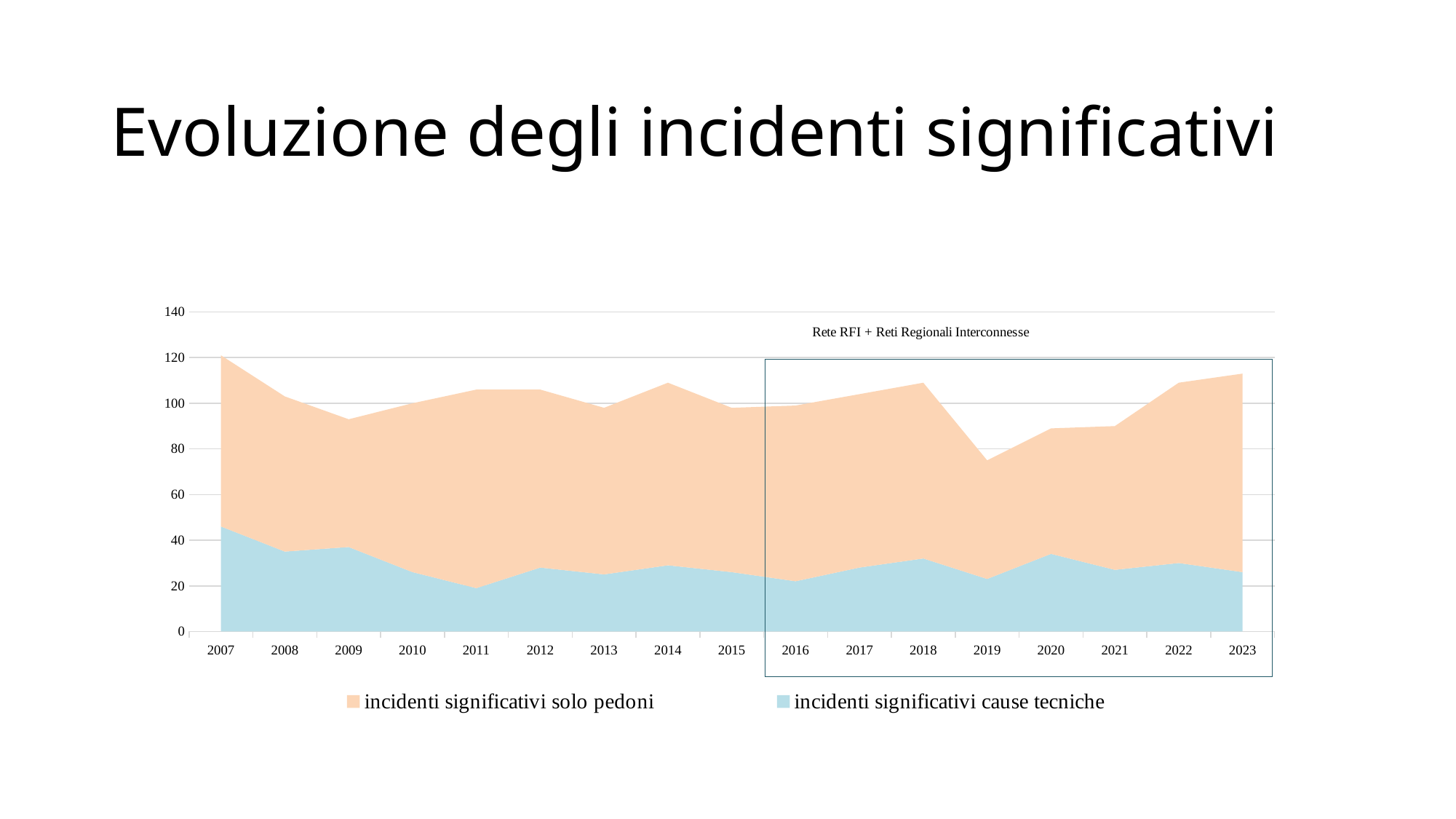
Does the value for 'incidenti significativi cause tecniche' rise or fall from 2007 to 2011? fall In which year is the total of significant incidents (top of the stacked area) lowest? 2019 What label is written above the boxed region covering 2016 to 2023? Rete RFI + Reti Regionali Interconnesse Is the total of significant incidents in 2023 greater or less than 100? greater Is the value for 'incidenti significativi cause tecniche' in 2007 greater or less than 40? greater How many series does the legend list? 2 Is the total of significant incidents in 2019 greater or less than 80? less In which year is the value for 'incidenti significativi cause tecniche' highest? 2007 In which year is the total of significant incidents (top of the stacked area) highest? 2007 What kind of chart is shown on the slide? Stacked area chart How many years are shown on the x axis? 17